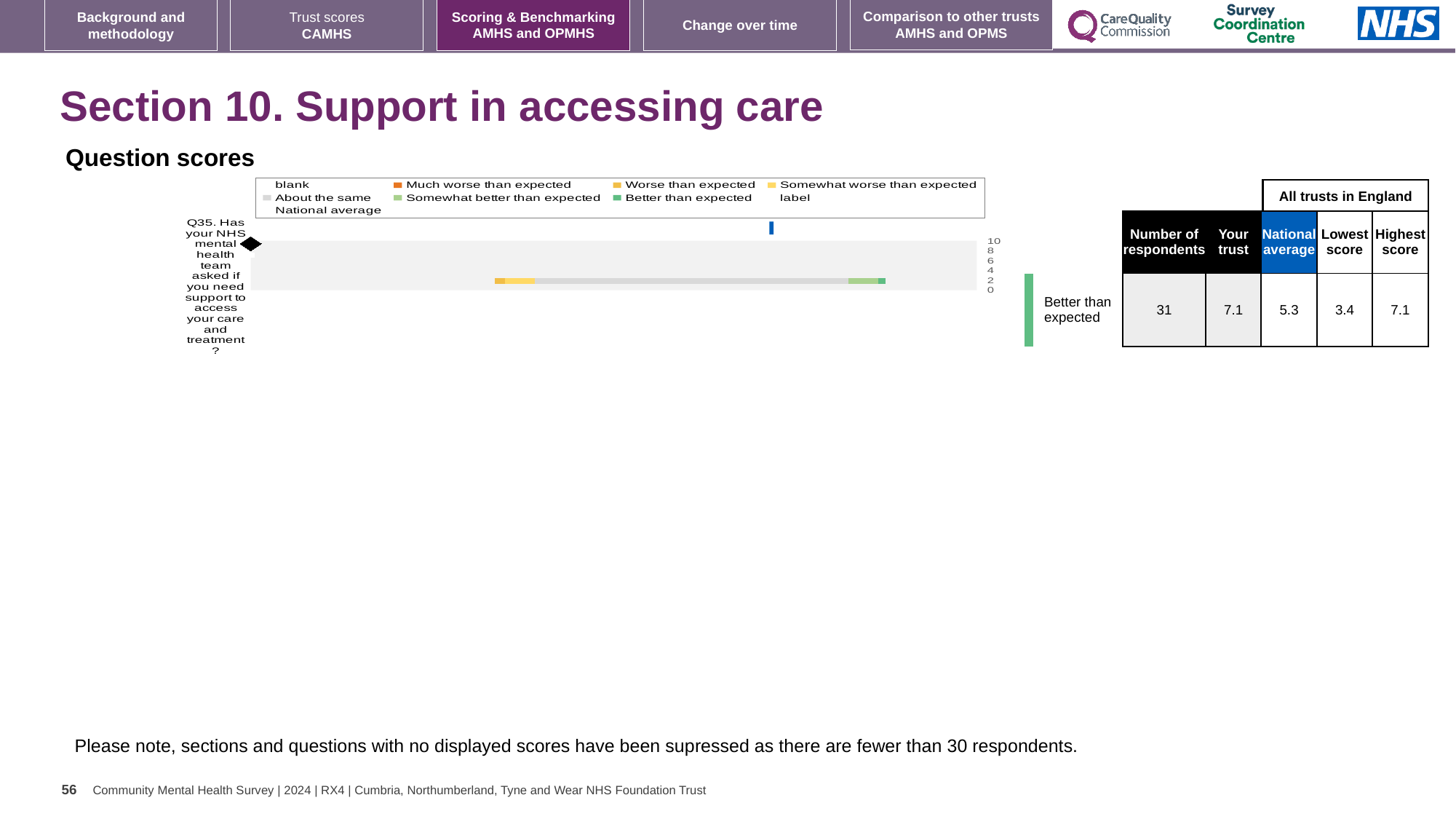
What is the 'Your trust' score for Q35? 7.1 How many survey questions are plotted in the Question scores chart? 1 What is the difference between the 'Your trust' score and the National average for Q35? 1.8 What is the National average score for Q35? 5.3 What is the Highest score among all trusts in England for Q35? 7.1 What benchmark category is shown for Q35 in the Question scores chart? Better than expected Which is larger for Q35, the 'Your trust' score or the National average? Your trust Which question is plotted in the Question scores chart? Q35. Has your NHS mental health team asked if you need support to access your care and treatment? What kind of chart is shown under 'Question scores'? bar chart What is the maximum value shown on the score axis of the Question scores chart? 10 What is the Lowest score among all trusts in England for Q35? 3.4 How many respondents answered Q35? 31